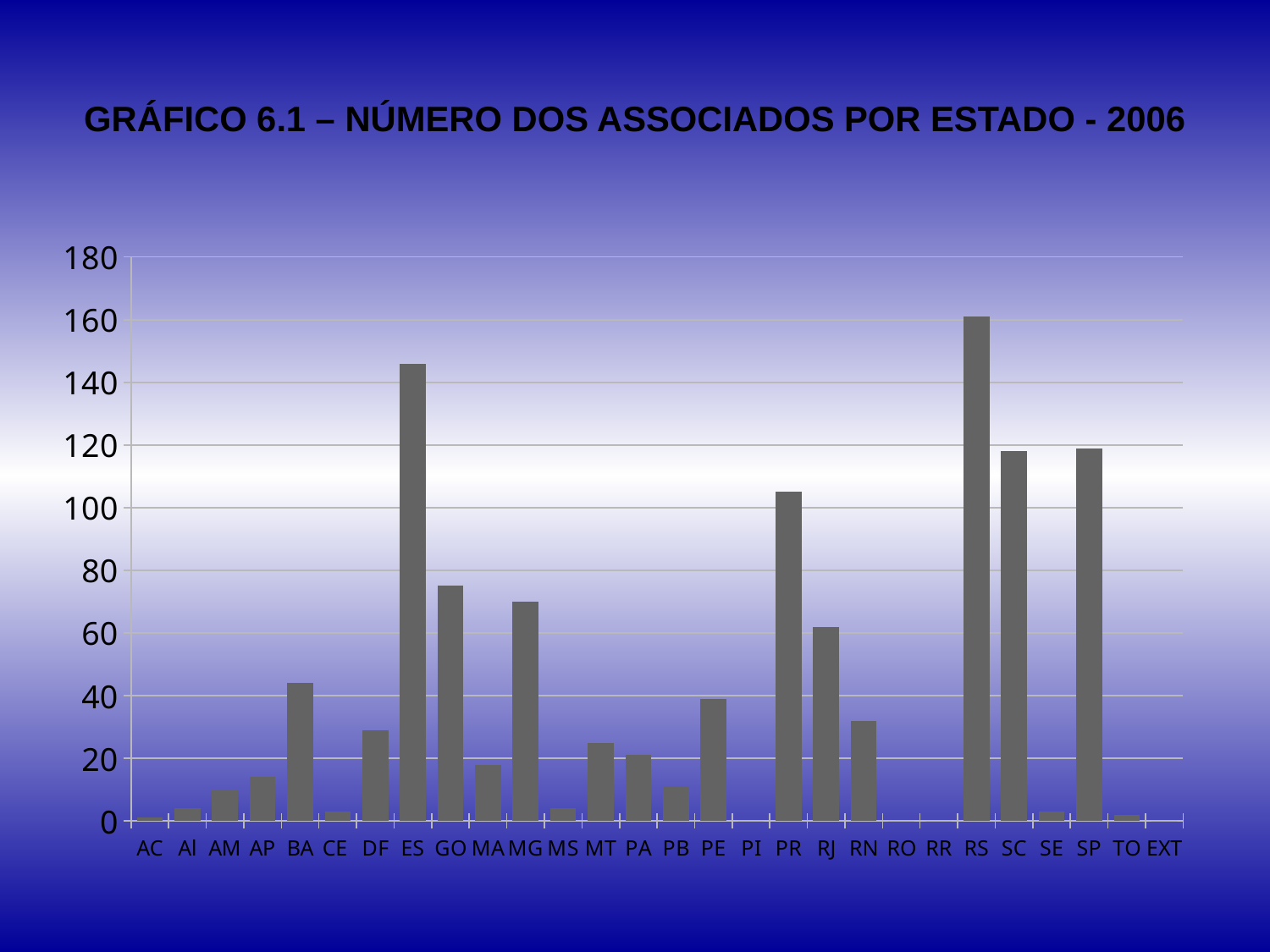
What is the title of the chart? GRÁFICO 6.1 – NÚMERO DOS ASSOCIADOS POR ESTADO - 2006 Which is larger, the value for PR or the value for RJ? PR Is the value for PR greater or less than 80? greater What kind of chart is shown on the slide? bar chart Is the value for GO greater or less than 60? greater Is the value for RS greater or less than 140? greater Which state has the highest number of associados in the chart? RS How many categories (states) are shown on the x axis of the chart? 28 Which is larger, the value for ES or the value for SP? ES